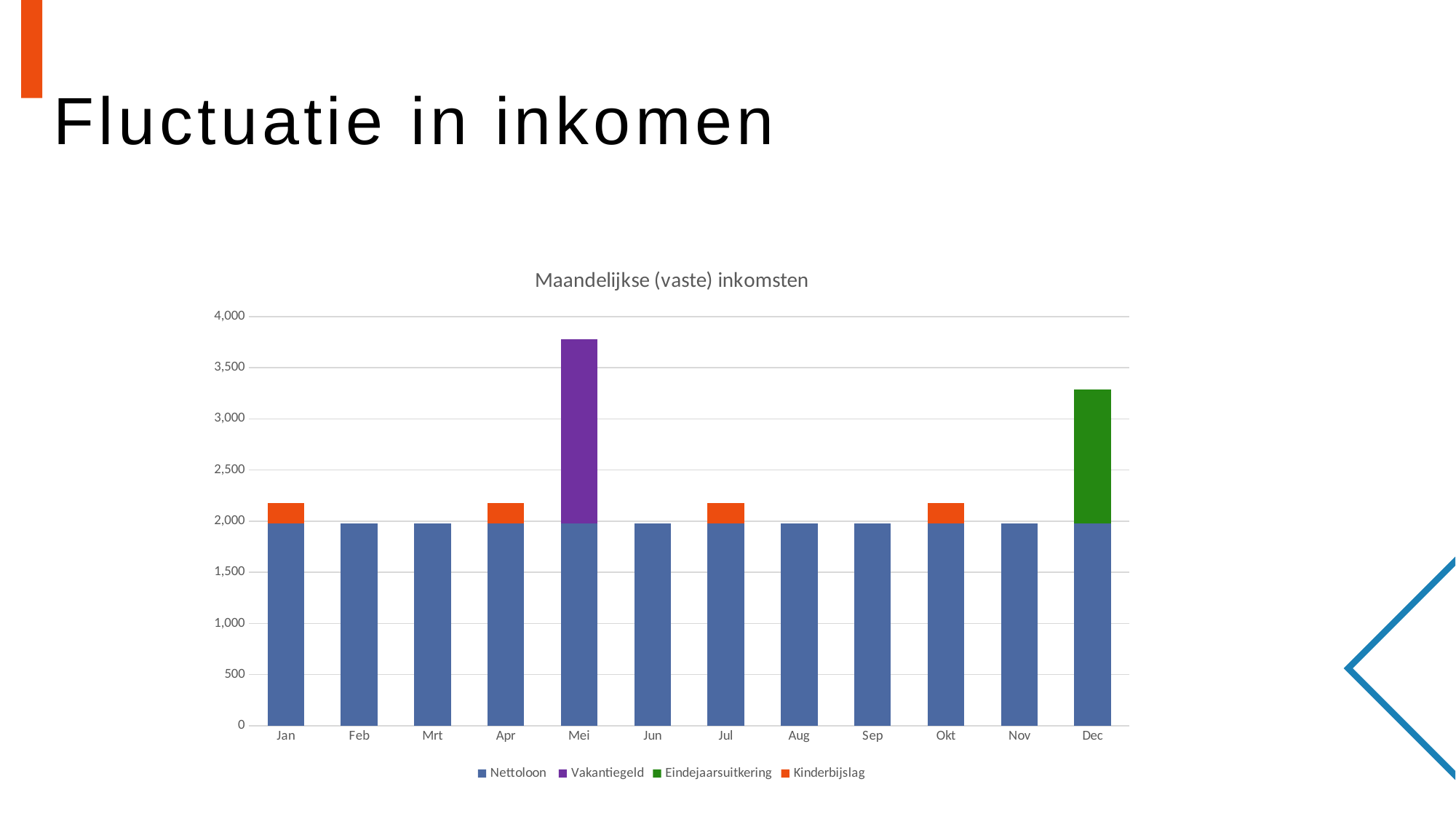
Is the total income for Mei greater or less than 3,500? greater How many series does the legend list? 4 What kind of chart is shown on the slide? bar chart Which month has the larger total income, Jan or Feb? Jan What is the title of the chart? Maandelijkse (vaste) inkomsten In which month does the Eindejaarsuitkering series appear? Dec Which month has the larger total income, Mei or Dec? Mei Is the Nettoloon value for Jun greater or less than 1,500? greater How many months are shown on the x axis? 12 Which month has the highest total income? Mei Is the total income for Dec greater or less than 3,000? greater